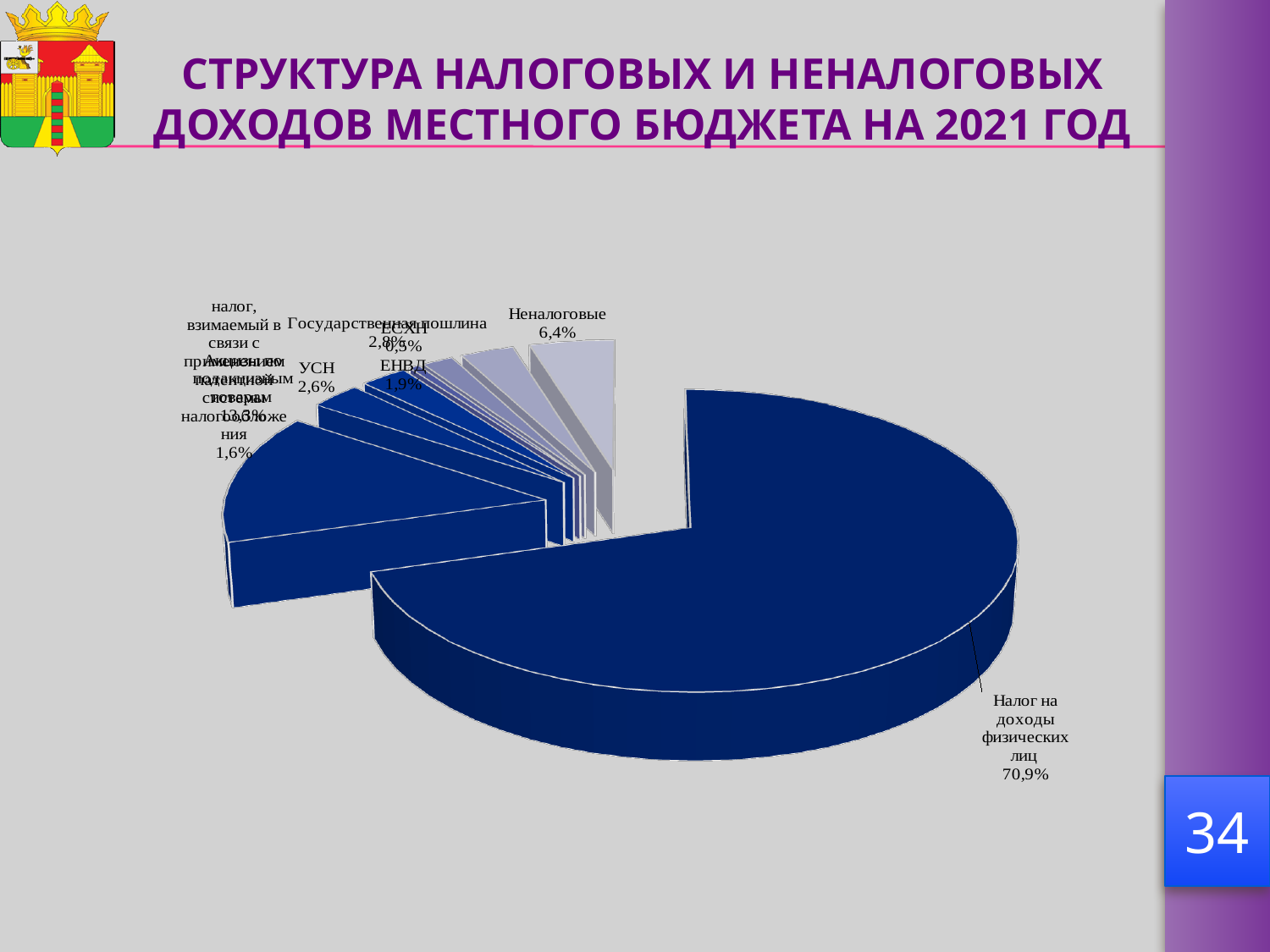
Which is larger, the "Неналоговые" slice or the "Государственная пошлина" slice? Неналоговые What value is shown for "УСН"? 2,6% What value is shown for "ЕСХН"? 0,5% Which labelled slice of the pie is the smallest? ЕСХН What kind of chart is shown on the slide? pie chart What share of the pie is labelled for "Налог на доходы физических лиц"? 70,9% What value is shown for the "Неналоговые" slice? 6,4% What is the title of the slide containing the pie chart? СТРУКТУРА НАЛОГОВЫХ И НЕНАЛОГОВЫХ ДОХОДОВ МЕСТНОГО БЮДЖЕТА НА 2021 ГОД What value is shown for "ЕНВД"? 1,9% By how many percentage points does "Налог на доходы физических лиц" exceed "Неналоговые"? 64,5% Which slice of the pie is the largest? Налог на доходы физических лиц What value is shown for "Государственная пошлина"? 2,8%